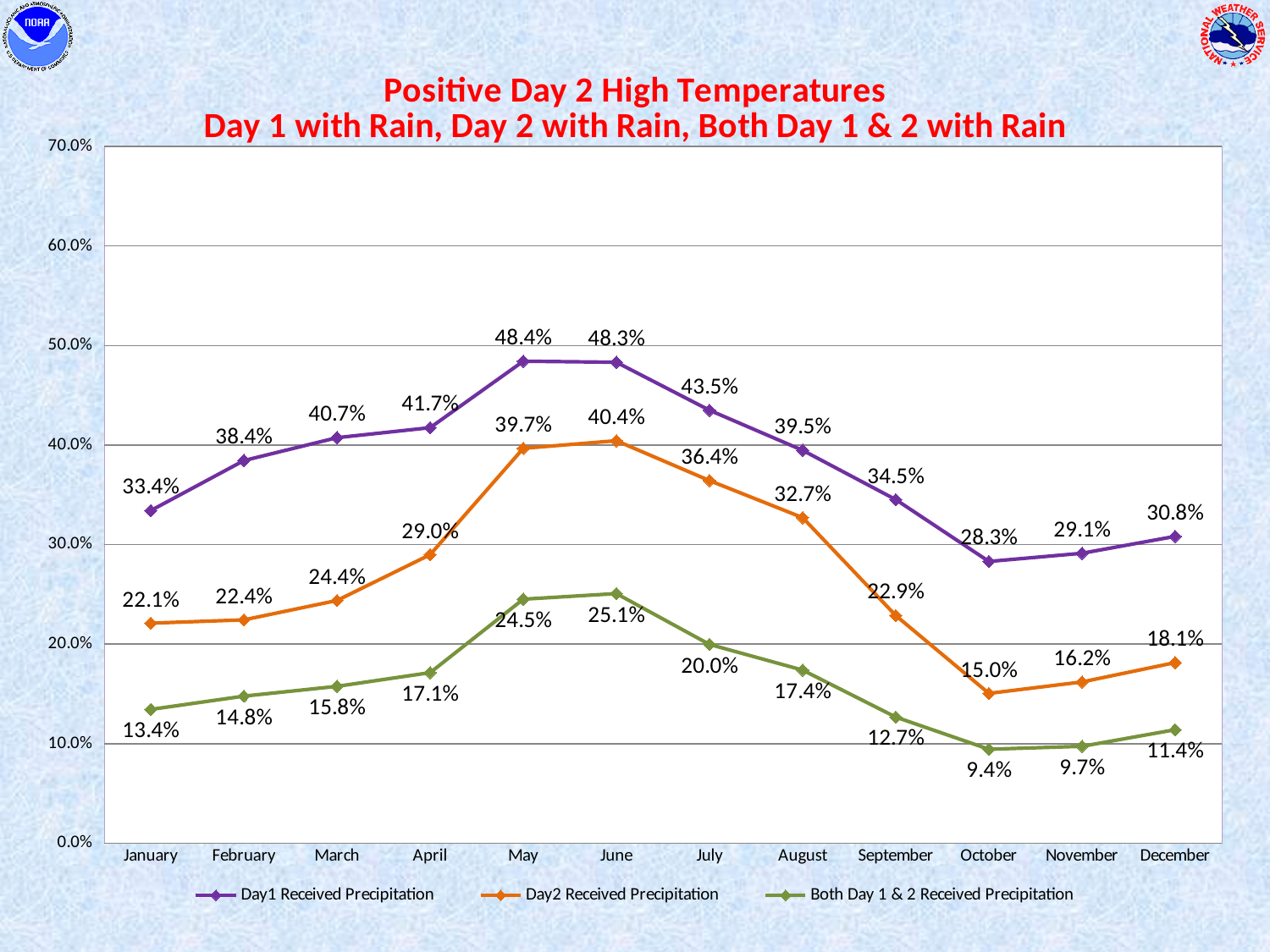
How many series does the legend list? 3 What is the difference between the Day1 and Day2 Received Precipitation values in January? 11.3% How many months are plotted along the x axis? 12 Which is larger in August: the Day2 Received Precipitation value or the Both Day 1 & 2 Received Precipitation value? Day2 Received Precipitation What type of chart is shown on the slide? line chart In which month is the Day2 Received Precipitation value highest? June What colour is the line for Both Day 1 & 2 Received Precipitation? green What is the value for Both Day 1 & 2 Received Precipitation in June? 25.1% What is the value for Day1 Received Precipitation in May? 48.4% In which month is the Day1 Received Precipitation value lowest? October What is the value for Day2 Received Precipitation in October? 15.0% Does the Day1 Received Precipitation series rise or fall from June to October? fall